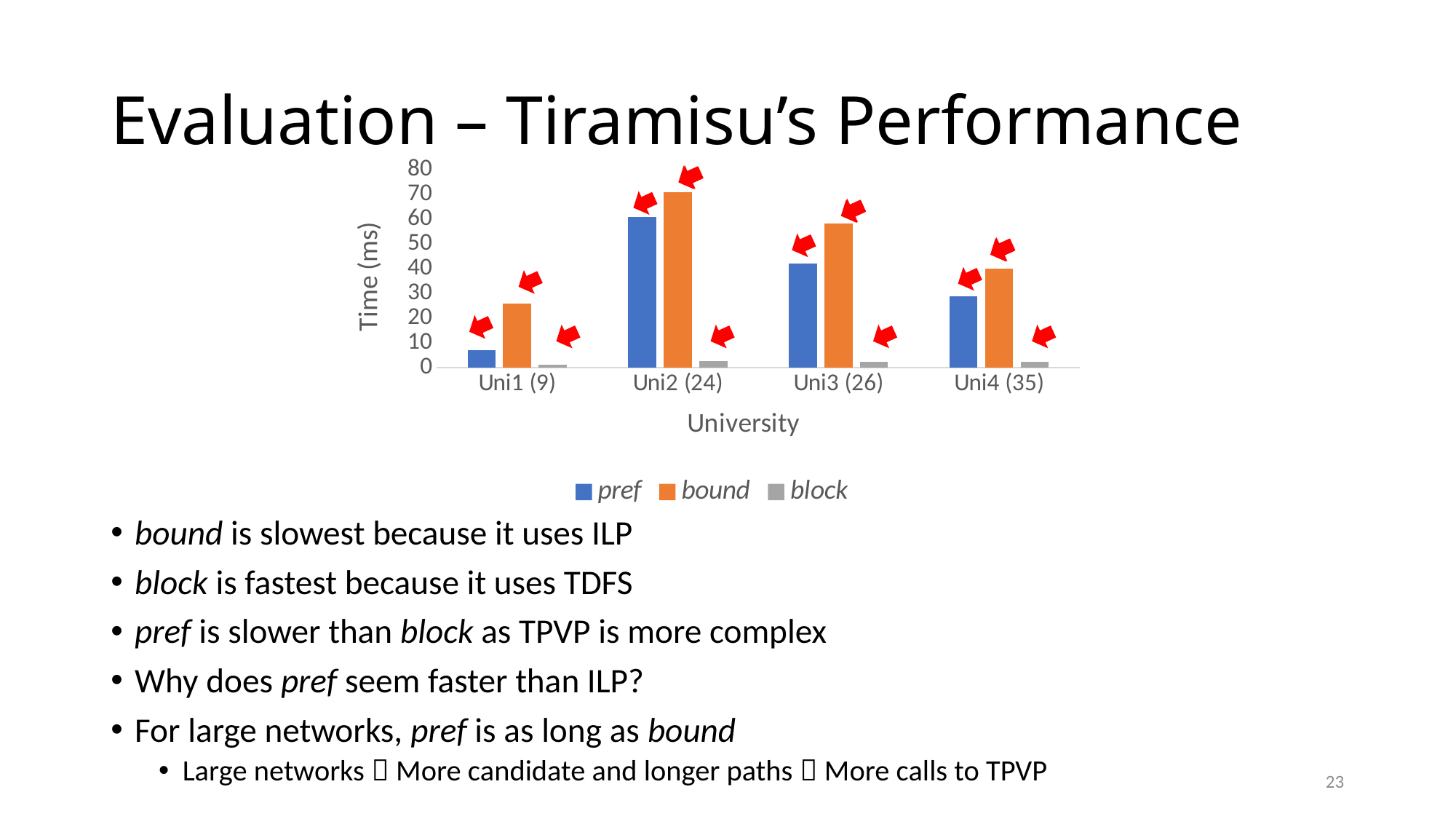
Is the bound value for Uni2 (24) greater or less than 60? greater What kind of chart is shown on the slide? bar chart Which university has the highest bound time? Uni2 (24) Is the pref value for Uni3 (26) greater or less than 30? greater What is the label of the y axis? Time (ms) Is the bound value for Uni4 (35) greater or less than 50? less How many university categories are shown on the x axis? 4 For Uni3 (26), which is larger, the pref time or the bound time? bound How many series does the legend list? 3 Which university has the lowest pref time? Uni1 (9) Which series is shown in orange in the legend? bound